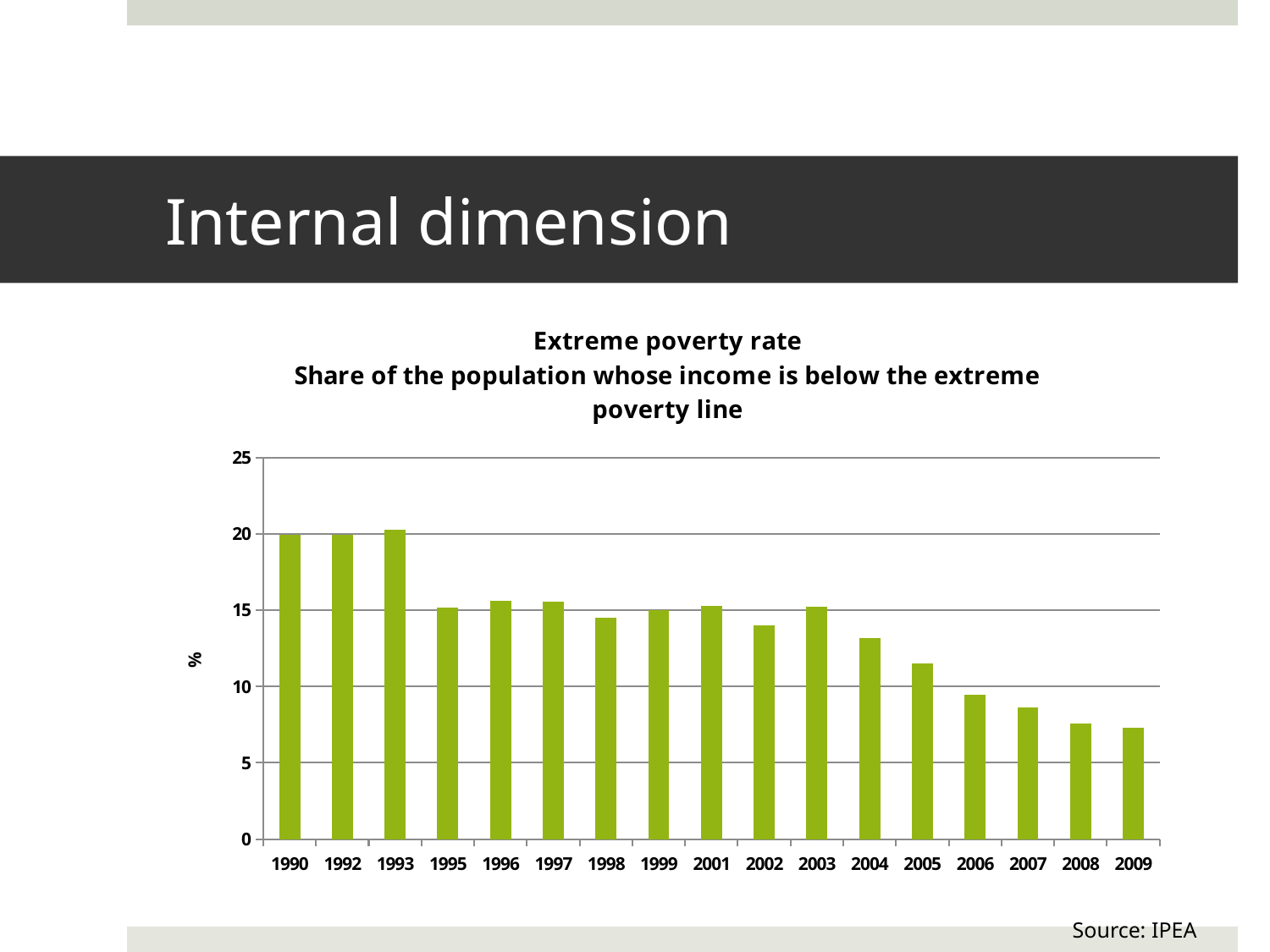
Is the value for 2004 greater or less than 10? greater Is the value for 2005 greater or less than 15? less Is the value for 1990 greater or less than 15? greater Do the extreme poverty rate values generally rise or fall from 1990 to 2009? fall What source is cited for the chart? IPEA Which year has the larger value, 1990 or 2009? 1990 Which year has the larger value, 2004 or 2005? 2004 What kind of chart is shown on the slide? bar chart What is the label on the y axis of the chart? % How many years are plotted on the x axis of the chart? 17